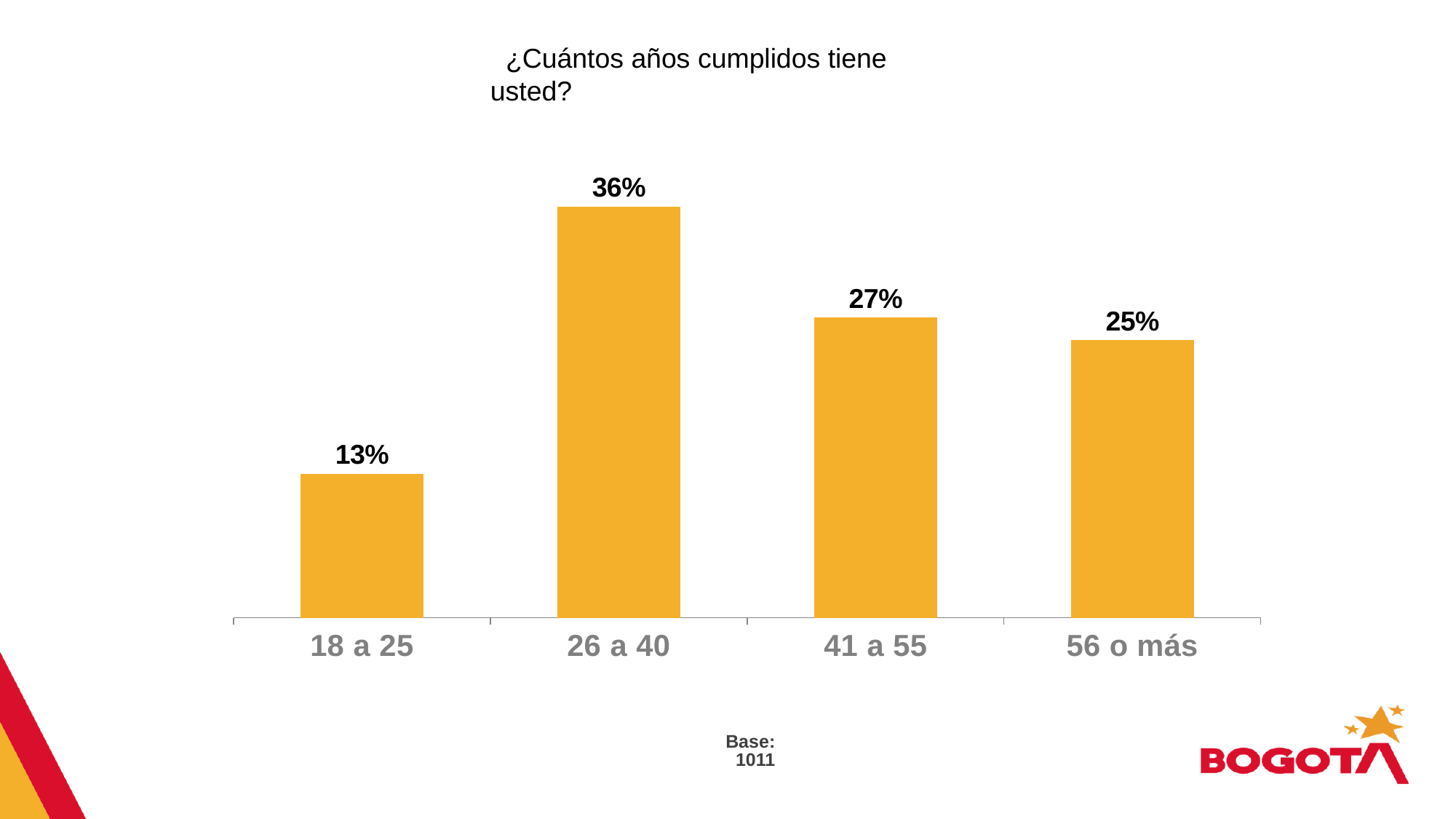
What is the base (number of respondents) noted below the chart? 1011 What is the difference between the 26 a 40 and 18 a 25 values? 23% What percentage of respondents are aged 18 a 25? 13% Which is larger, the value for 41 a 55 or the value for 18 a 25? 41 a 55 What kind of chart is shown on the slide? Bar chart What is the value shown for the 26 a 40 age group? 36% Which age group has the lowest percentage? 18 a 25 Which age group has the highest percentage? 26 a 40 What percentage is shown for the 41 a 55 category? 27% What is the value for the 56 o más age group? 25% What is the difference between the 41 a 55 and 56 o más values? 2% How many age categories are shown on the chart? 4